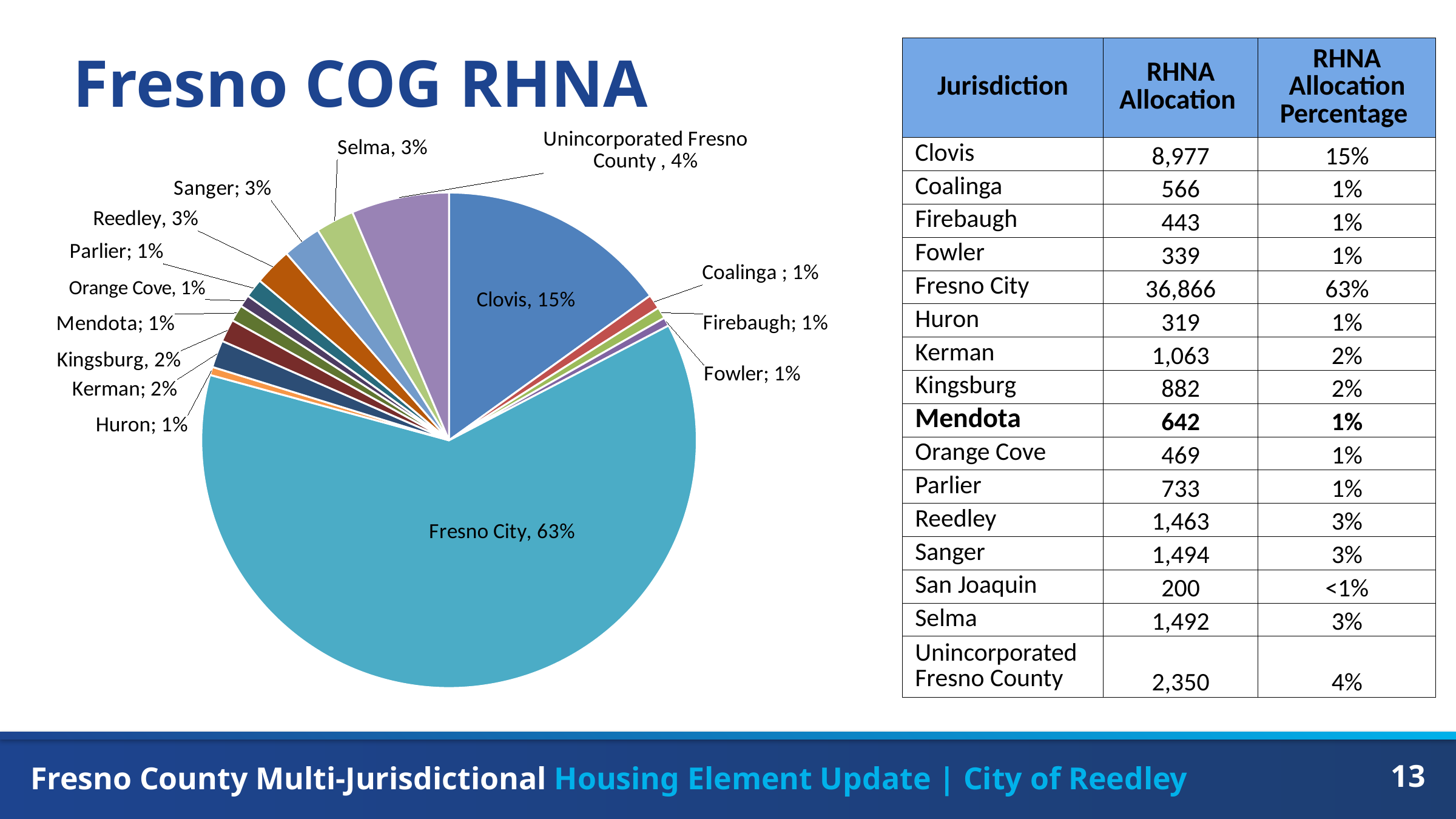
What percentage is shown for Unincorporated Fresno County in the pie chart? 4% What share of the pie does Fresno City hold? 63% What percentage is shown for Kerman in the pie chart? 2% What kind of chart is shown on the slide? pie chart What percentage is shown for Clovis in the pie chart? 15% Which is larger in the pie chart, Fresno City or Clovis? Fresno City By how many percentage points does Unincorporated Fresno County's share exceed Kingsburg's share in the pie chart? 2 percentage points What percentage is shown for Selma in the pie chart? 3% Which is larger in the pie chart, Clovis or Unincorporated Fresno County? Clovis What is the title of the slide containing the pie chart? Fresno COG RHNA Which jurisdiction has the largest slice of the pie chart? Fresno City By how many percentage points does Fresno City's share exceed Clovis's share in the pie chart? 48 percentage points